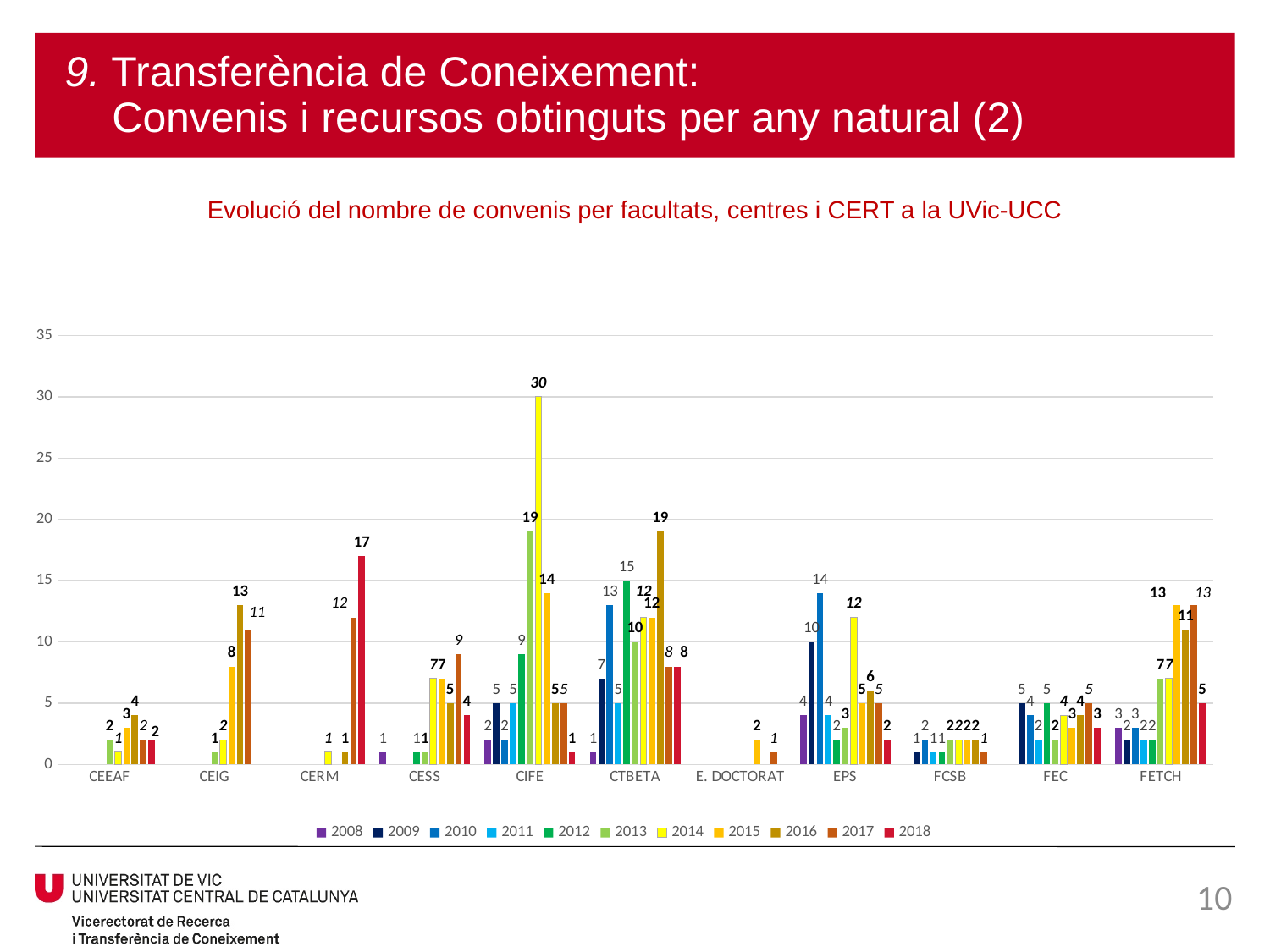
Is the value for CIFE in 2014 greater or less than 25? greater What is the value for CTBETA in 2016? 19 What is the title of the chart? Evolució del nombre de convenis per facultats, centres i CERT a la UVic-UCC How many series (years) does the legend list? 11 Which is larger: the value for CIFE in 2014 or the value for CERM in 2018? CIFE in 2014 What is the value for CERM in 2018? 17 What is the value for EPS in 2010? 14 How many categories (faculties/centres) are shown along the x axis? 11 What kind of chart is shown on the slide? bar chart Which category contains the tallest bar in the chart? CIFE What is the difference between the value for CIFE in 2014 and the value for CTBETA in 2016? 11 What is the value for CIFE in 2014? 30